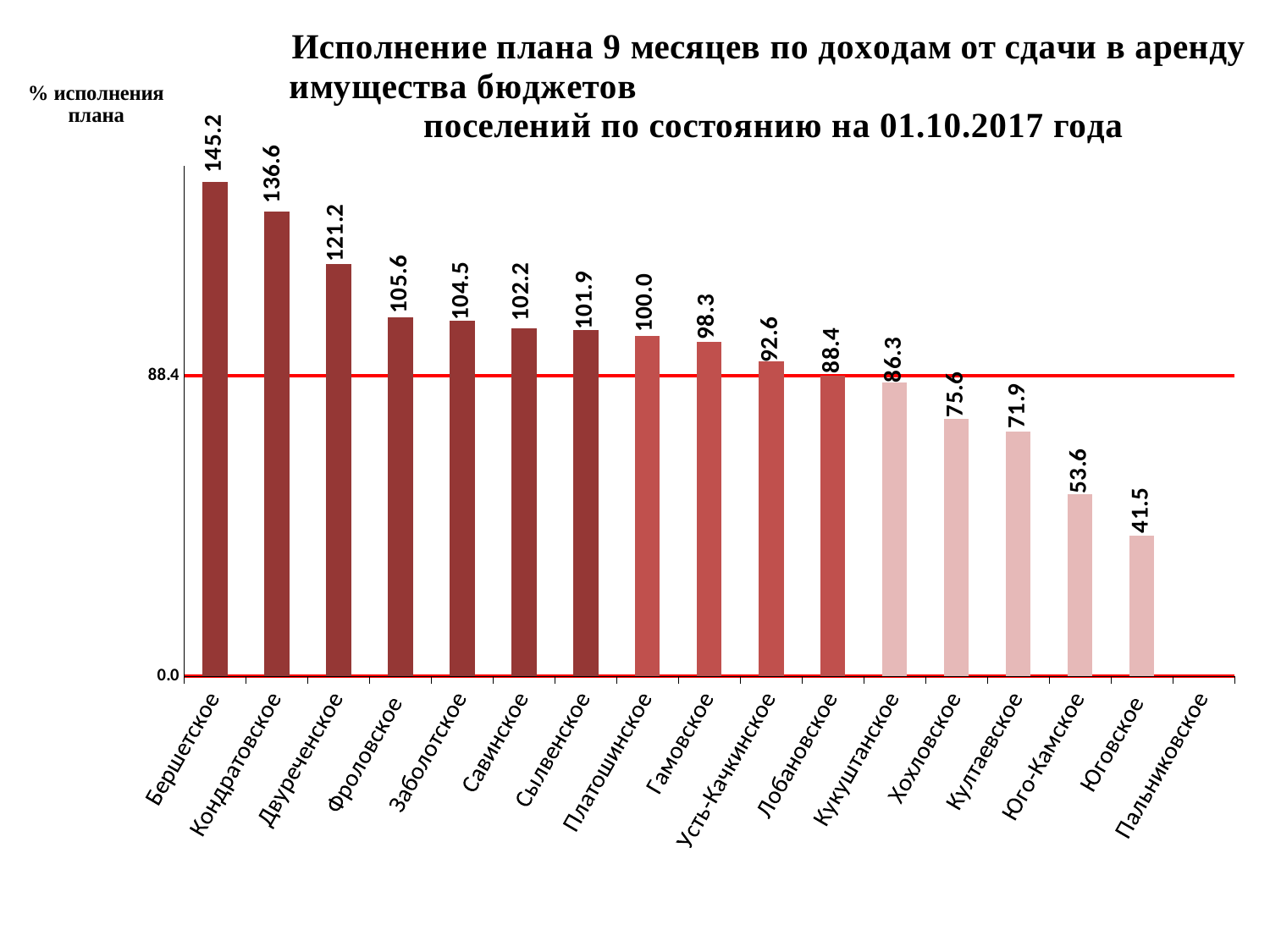
What is the value for Платошинское? 100.0 What is the value for Хохловское? 75.6 What type of chart is shown on the slide? Bar chart What is the value for Бершетское? 145.2 What is the difference between the values for Лобановское and Юговское? 46.9 How many bars are plotted on the chart? 16 Which category with a plotted bar has the lowest value? Юговское What value is marked by the horizontal red line across the chart? 88.4 Which category has the highest value? Бершетское Do the values rise or fall from left to right along the x axis? Fall What is the difference between the values for Бершетское and Кондратовское? 8.6 Which is larger, the value for Двуреченское or the value for Фроловское? Двуреченское